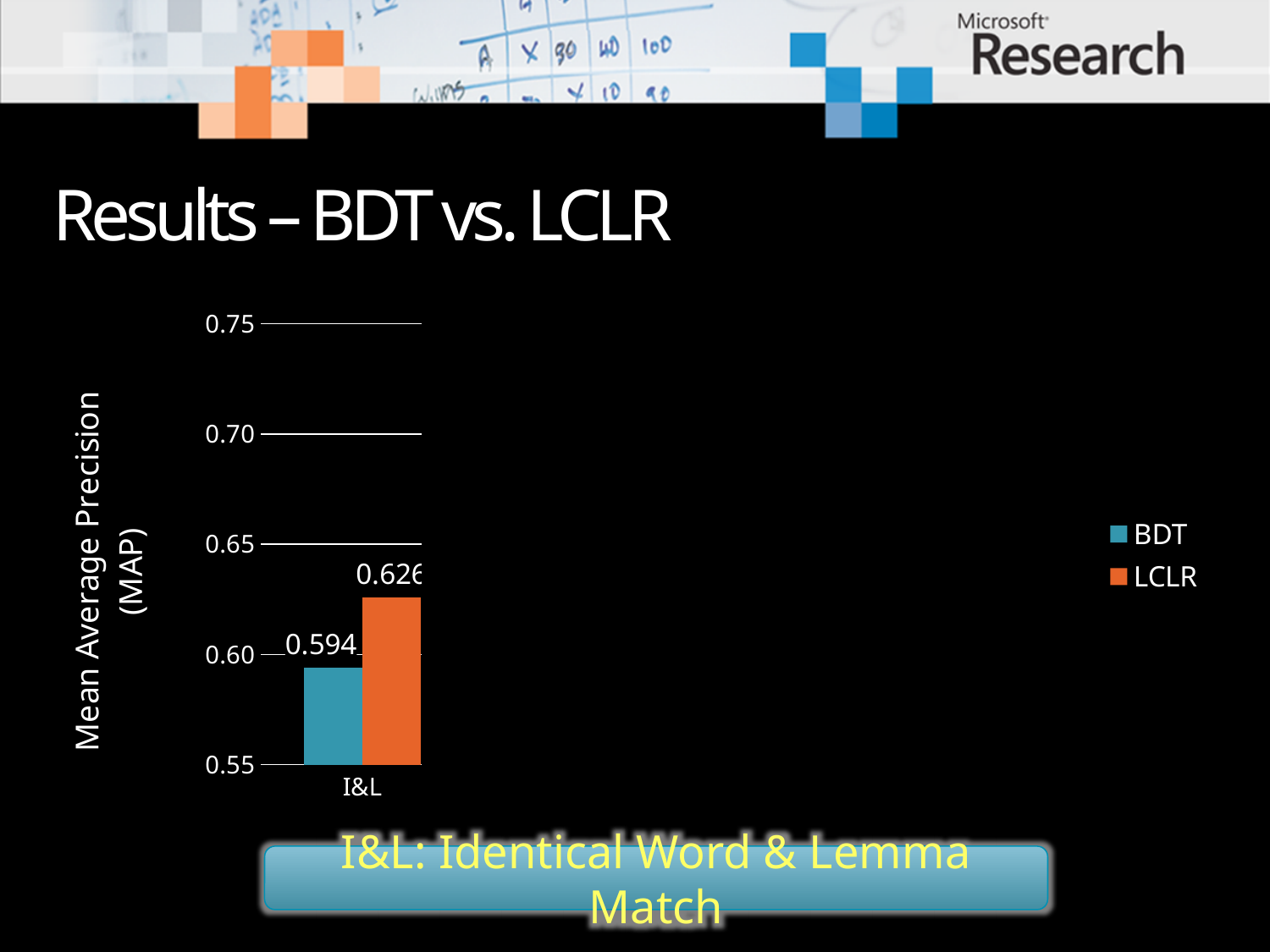
What is the MAP value for BDT on the I&L category? 0.594 Is the MAP value for BDT greater or less than 0.60? less Which series has the lowest MAP value shown in the chart? BDT What kind of chart is shown on the slide? bar chart Is the MAP value for LCLR greater or less than 0.65? less How many categories are shown on the x axis of the chart? 1 What colour are the LCLR bars in the chart? orange Which series has the higher MAP for I&L, BDT or LCLR? LCLR How many series does the legend list? 2 What is the difference between the LCLR and BDT MAP values for I&L? 0.032 What is the MAP value for LCLR on the I&L category? 0.626 What is the label of the y axis? Mean Average Precision (MAP)